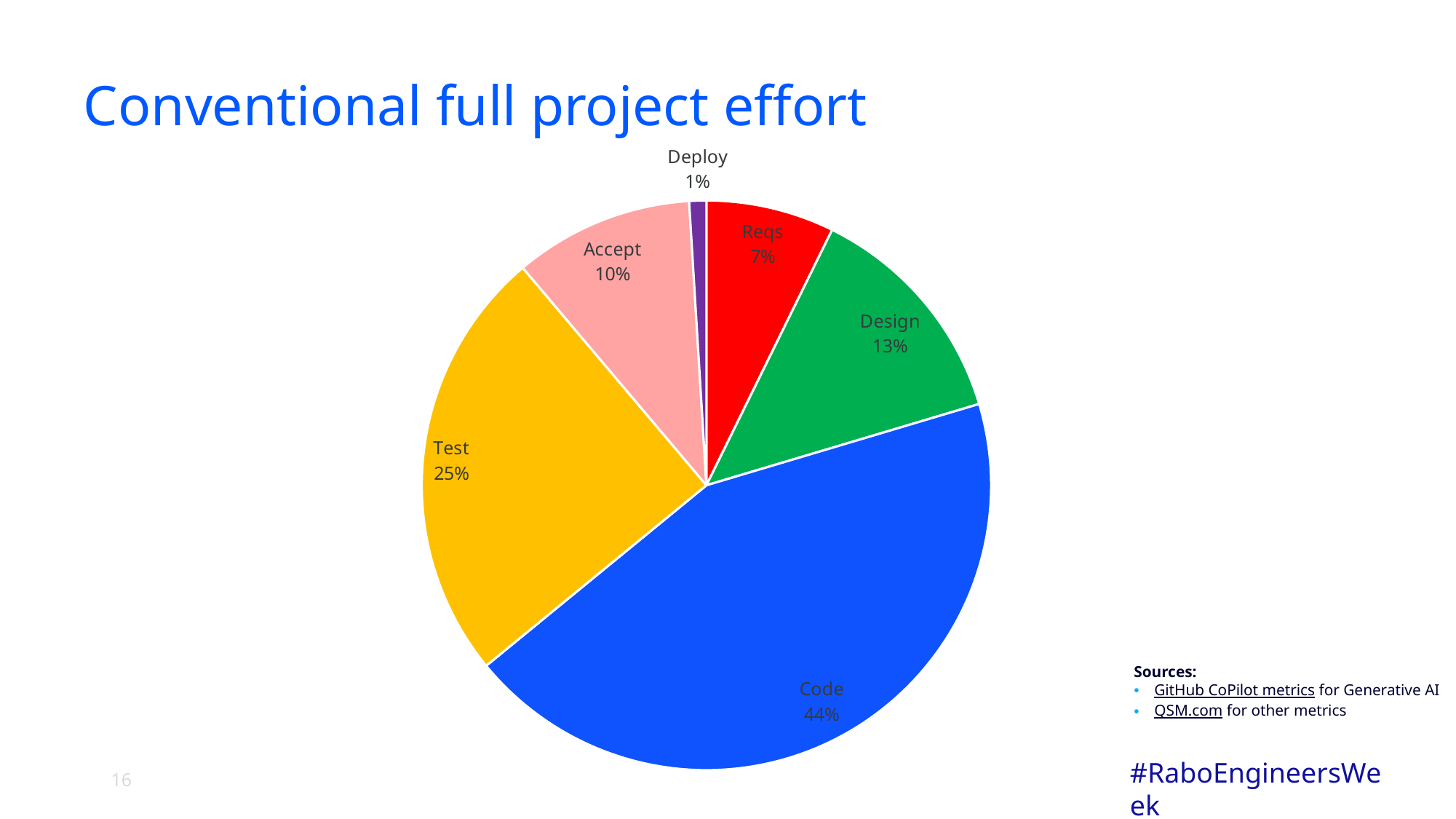
How many slices does the pie chart have? 6 What kind of chart is shown on the slide? pie chart Which category has the largest slice? Code What share of the pie does Code take? 44% Which is larger, Design or Accept? Design What is the title of the slide's chart? Conventional full project effort What is the difference between the Code and Test shares? 19% Which category has the smallest slice? Deploy What is the value for Accept? 10% What is the value for Test? 25% What is the value for Design? 13% What is the value for Reqs? 7%